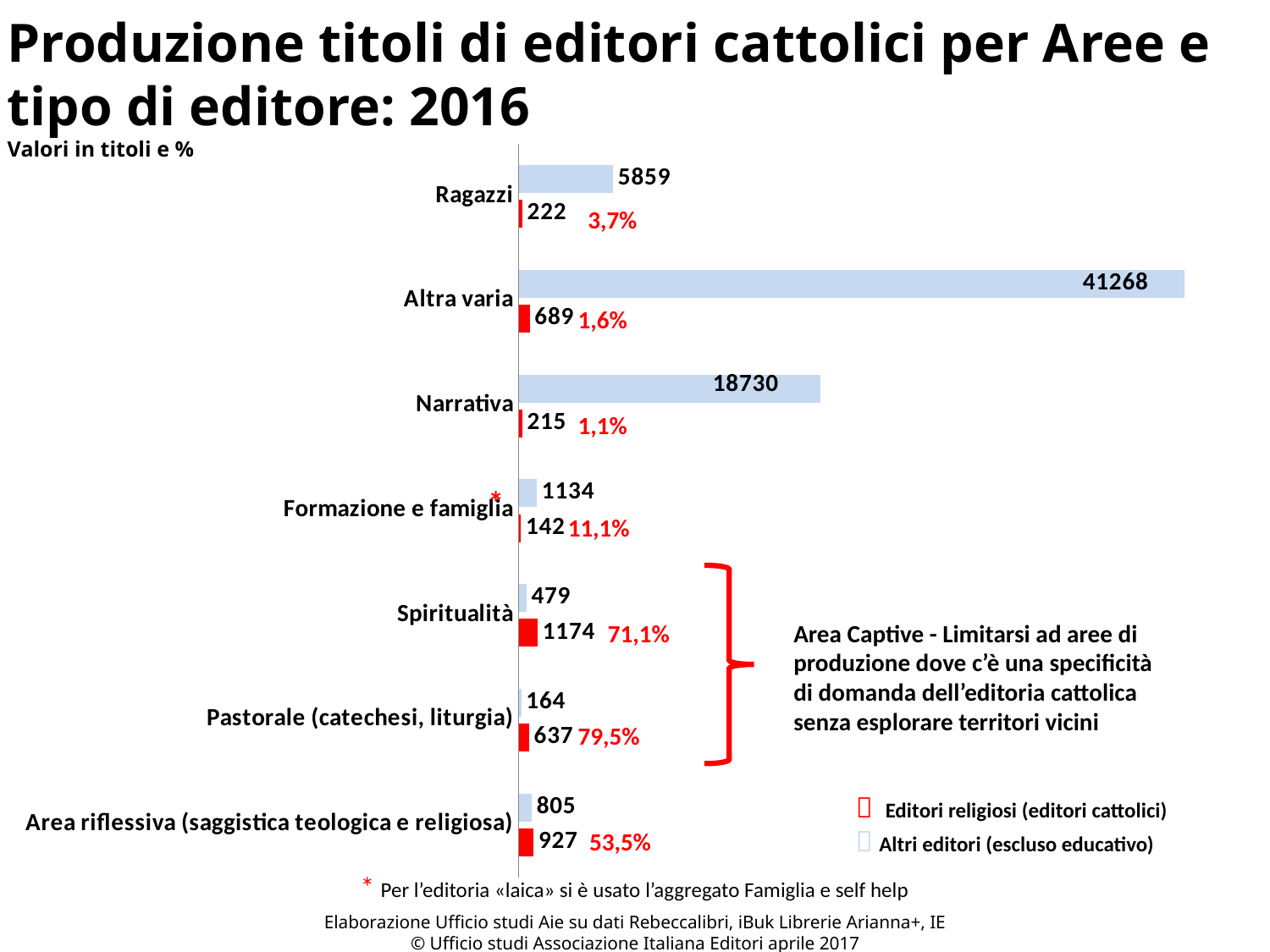
Which category has the highest value for Editori religiosi (editori cattolici)? Spiritualità What is the difference between the Altri editori and Editori religiosi values in the Narrativa category? 18515 What is the value for Altri editori (escluso educativo) in the Altra varia category? 41268 What percentage is shown next to the Pastorale (catechesi, liturgia) category? 79,5% What type of chart is shown on the slide? Bar chart Which category has the highest value for Altri editori (escluso educativo)? Altra varia What is the value for Editori religiosi (editori cattolici) in the Ragazzi category? 222 How many series does the legend list? 2 How many categories are shown on the chart? 7 In the Area riflessiva (saggistica teologica e religiosa) category, which series has the larger value, Editori religiosi or Altri editori? Editori religiosi (editori cattolici) Which category has the lowest value for Altri editori (escluso educativo)? Pastorale (catechesi, liturgia) What is the value for Editori religiosi (editori cattolici) in the Spiritualità category? 1174